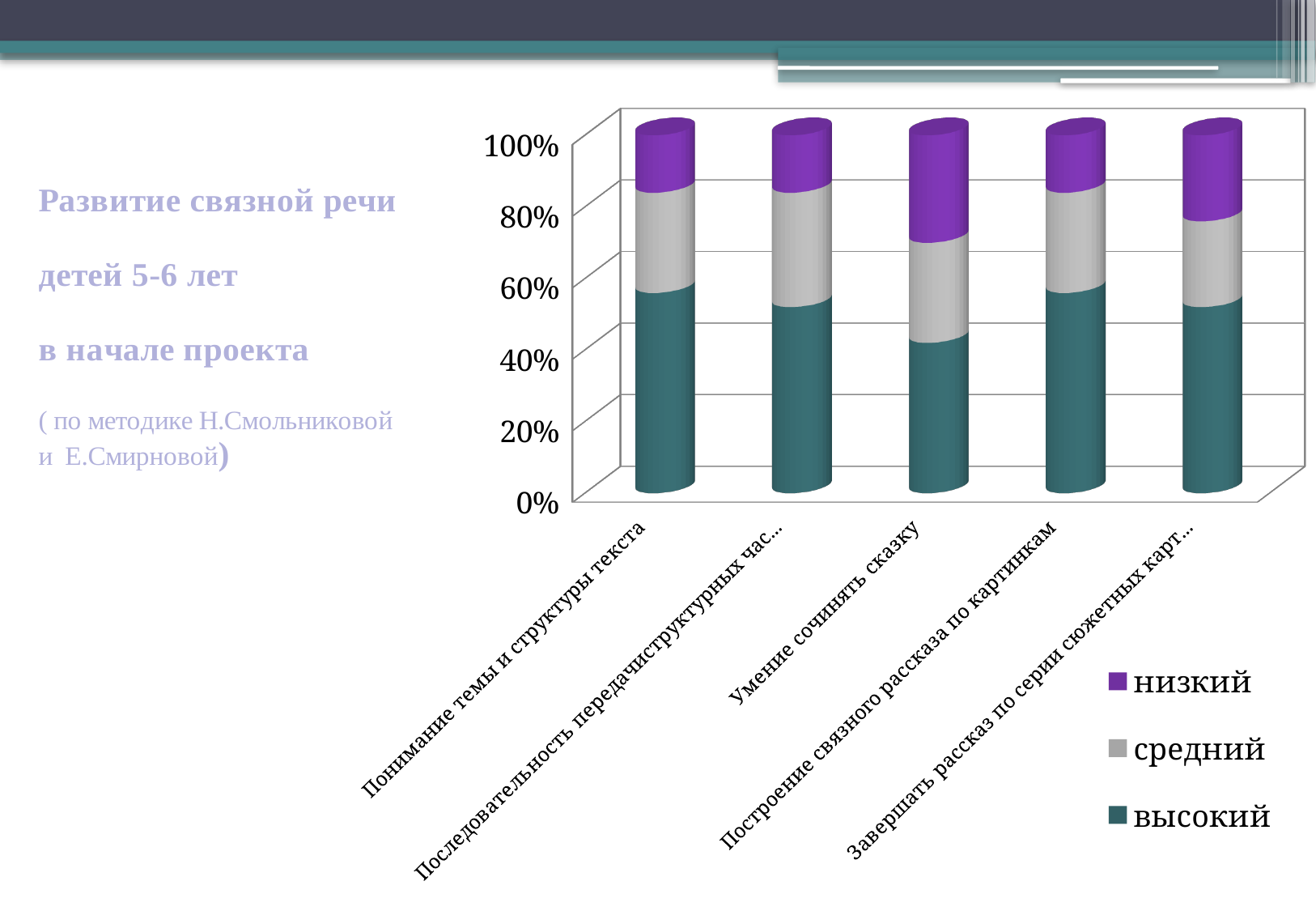
Is the 'высокий' share for 'Понимание темы и структуры текста' greater or less than 50%? greater How many series does the chart legend list? 3 What are the three series named in the legend? низкий, средний, высокий Which has the larger 'высокий' share: 'Понимание темы и структуры текста' or 'Умение сочинять сказку'? Понимание темы и структуры текста What kind of chart is shown on the slide? stacked bar chart How many categories (bars) are plotted in the chart? 5 Is the 'низкий' share for 'Построение связного рассказа по картинкам' greater or less than 20%? less Which colour represents the series 'высокий' in the chart? dark teal Is the 'низкий' share for 'Умение сочинять сказку' greater or less than 20%? greater Which category has the largest 'низкий' share? Умение сочинять сказку Which category has the smallest 'высокий' share? Умение сочинять сказку